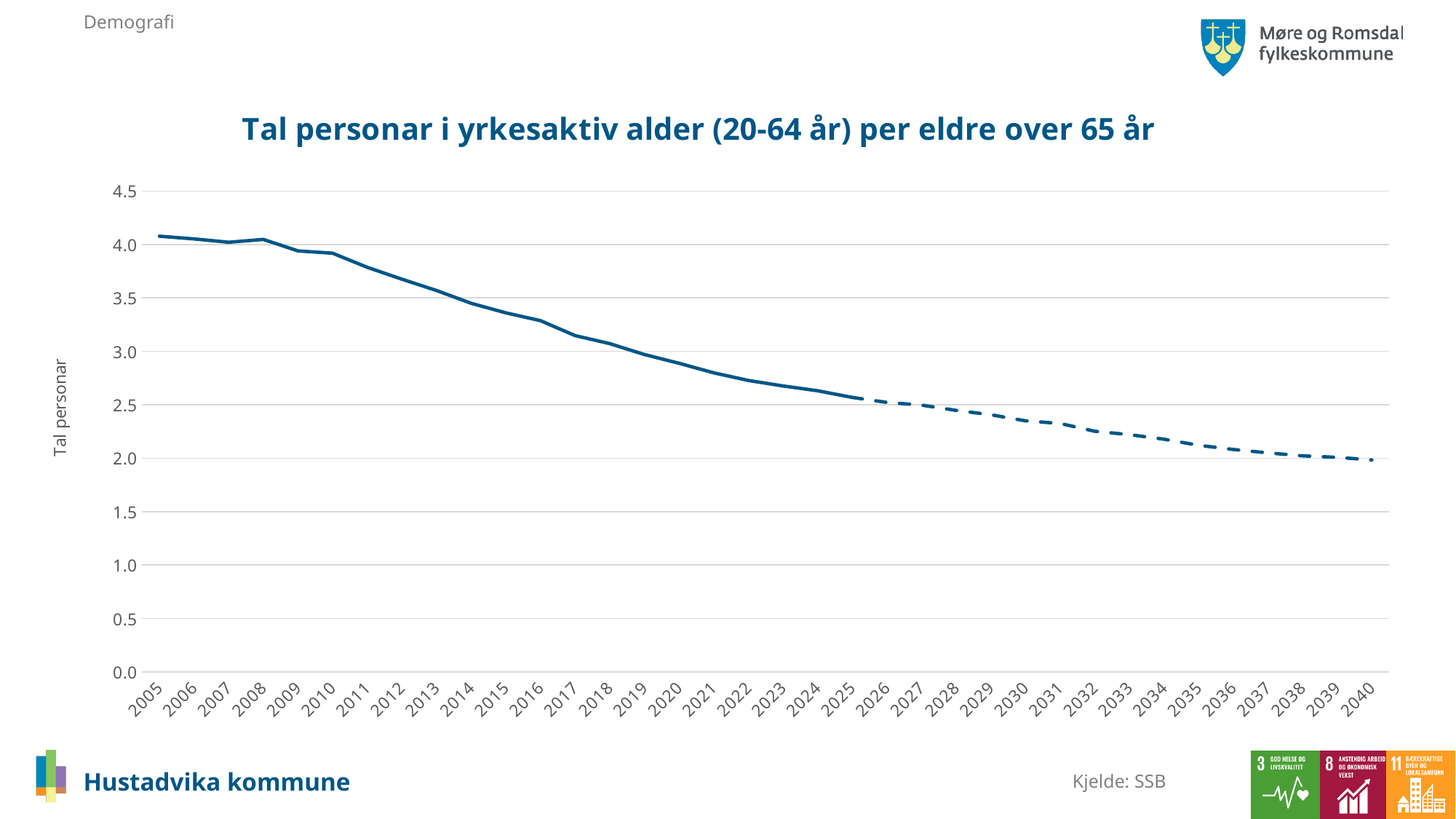
What kind of chart is shown on the slide? line chart Which year has the lowest value? 2040 Is the value for 2013 greater or less than 3.5? greater Which is larger, the value for 2016 or the value for 2030? 2016 Which is larger, the value for 2005 or the value for 2040? 2005 Is the value for 2022 greater or less than 3.0? less Is the value for 2005 greater or less than 4.0? greater How many years are shown on the x axis? 36 What is the title of the chart? Tal personar i yrkesaktiv alder (20-64 år) per eldre over 65 år Do the values rise or fall from 2005 to 2040? fall